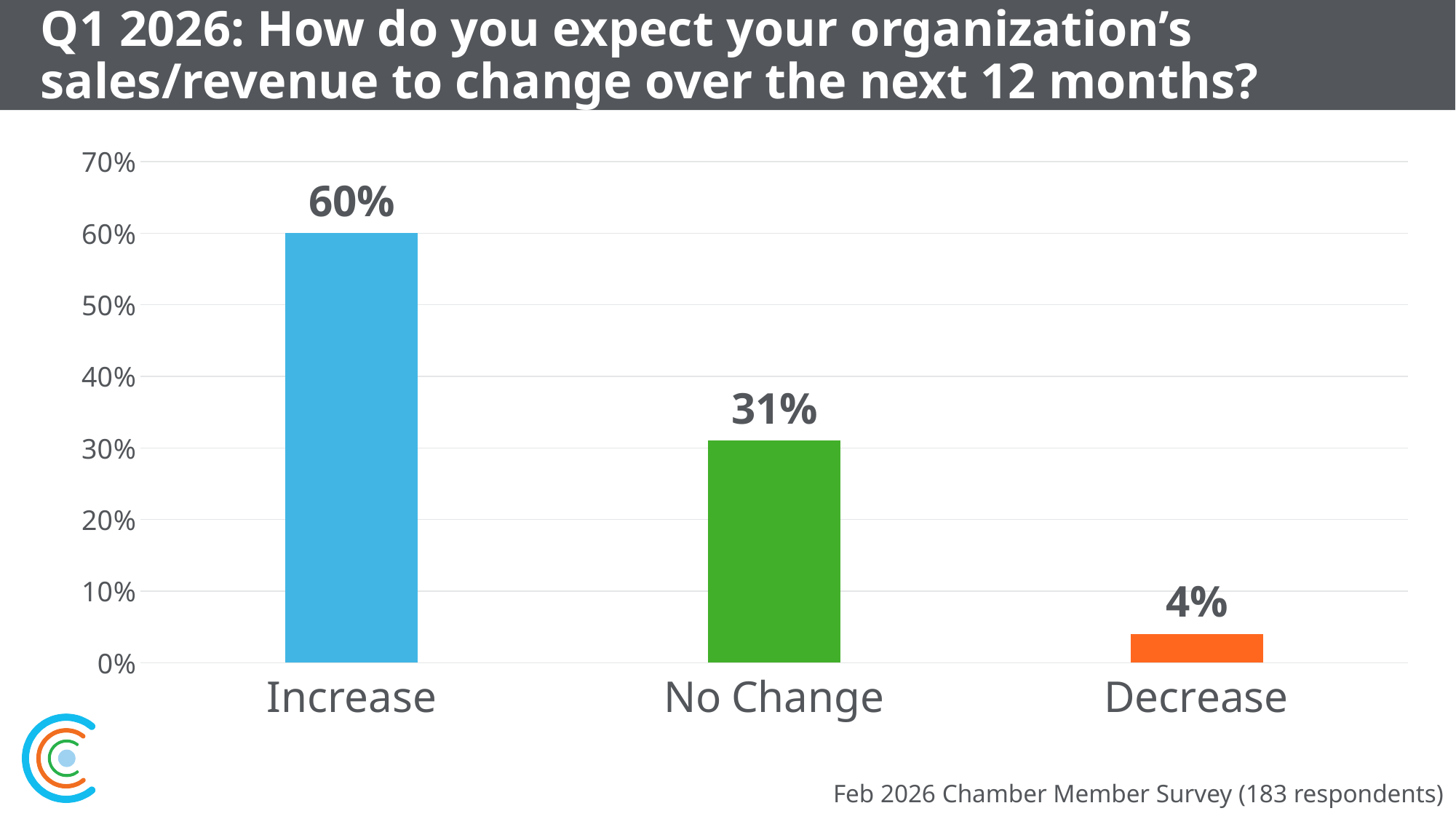
Is the value for Increase greater or less than 50%? greater Which response category has the lowest percentage? Decrease How many response categories are shown on the chart? 3 What kind of chart is shown on the slide? Bar chart Which response category has the highest percentage? Increase What is the difference in percentage points between Increase and No Change? 29 What percentage of respondents expect their sales/revenue to decrease? 4% What percentage of respondents expect no change in sales/revenue? 31% Which is larger, the value for No Change or the value for Decrease? No Change What is the highest value shown on the vertical axis? 70% What percentage of respondents expect their organization's sales/revenue to increase? 60% What is the difference in percentage points between No Change and Decrease? 27